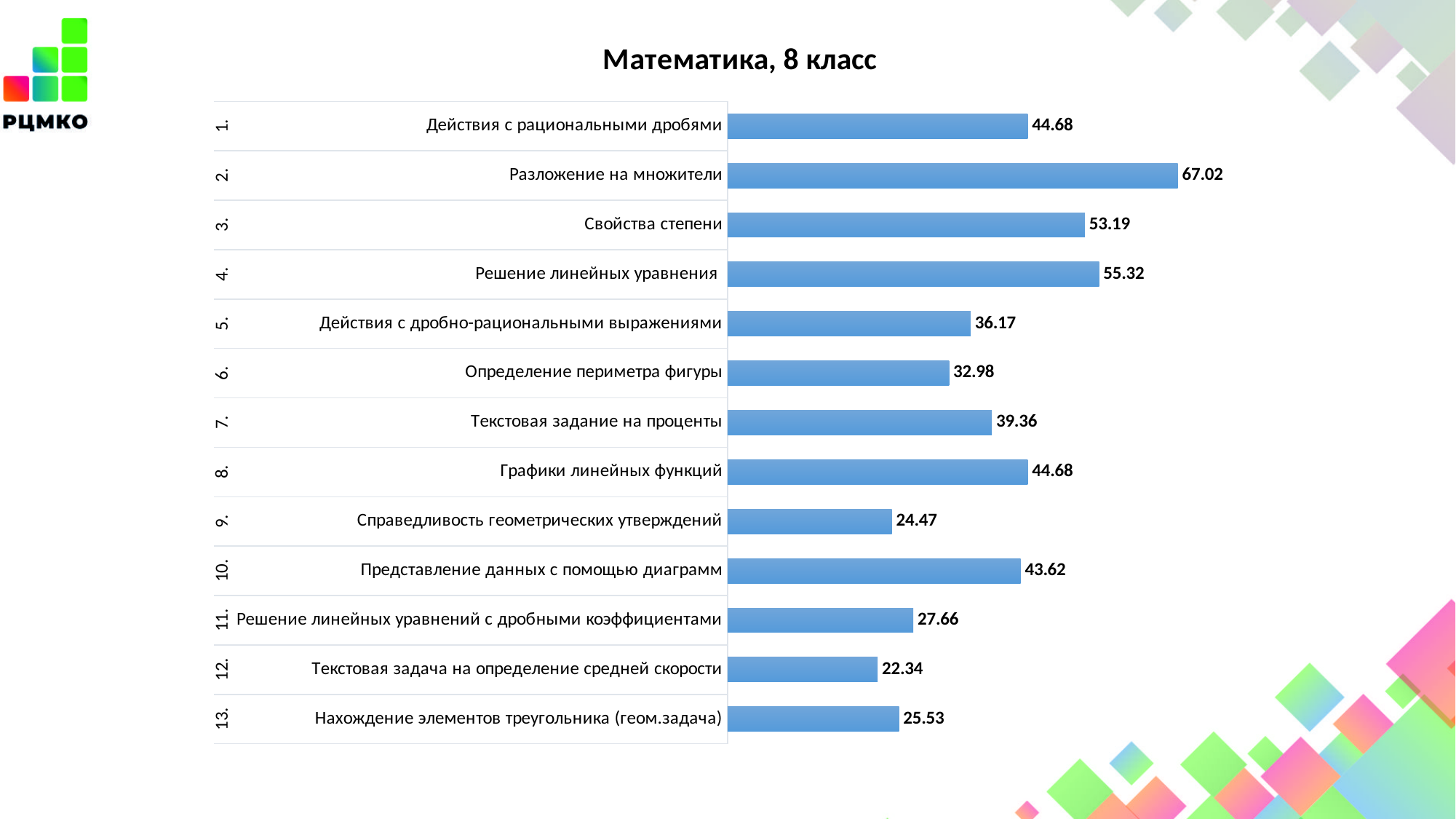
How many categories are shown in the chart? 13 Which category has the lowest value? Текстовая задача на определение средней скорости Which is larger: the value for "Текстовая задание на проценты" or the value for "Действия с дробно-рациональными выражениями"? Текстовая задание на проценты What is the title of the chart? Математика, 8 класс What is the value for "Текстовая задача на определение средней скорости"? 22.34 What is the difference between the values for "Свойства степени" and "Решение линейных уравнения"? 2.13 What is the difference between the values for "Разложение на множители" and "Справедливость геометрических утверждений"? 42.55 What kind of chart is shown on the slide? Bar chart What is the value for "Определение периметра фигуры"? 32.98 What is the value for "Разложение на множители"? 67.02 What is the value for "Графики линейных функций"? 44.68 Which category has the highest value? Разложение на множители